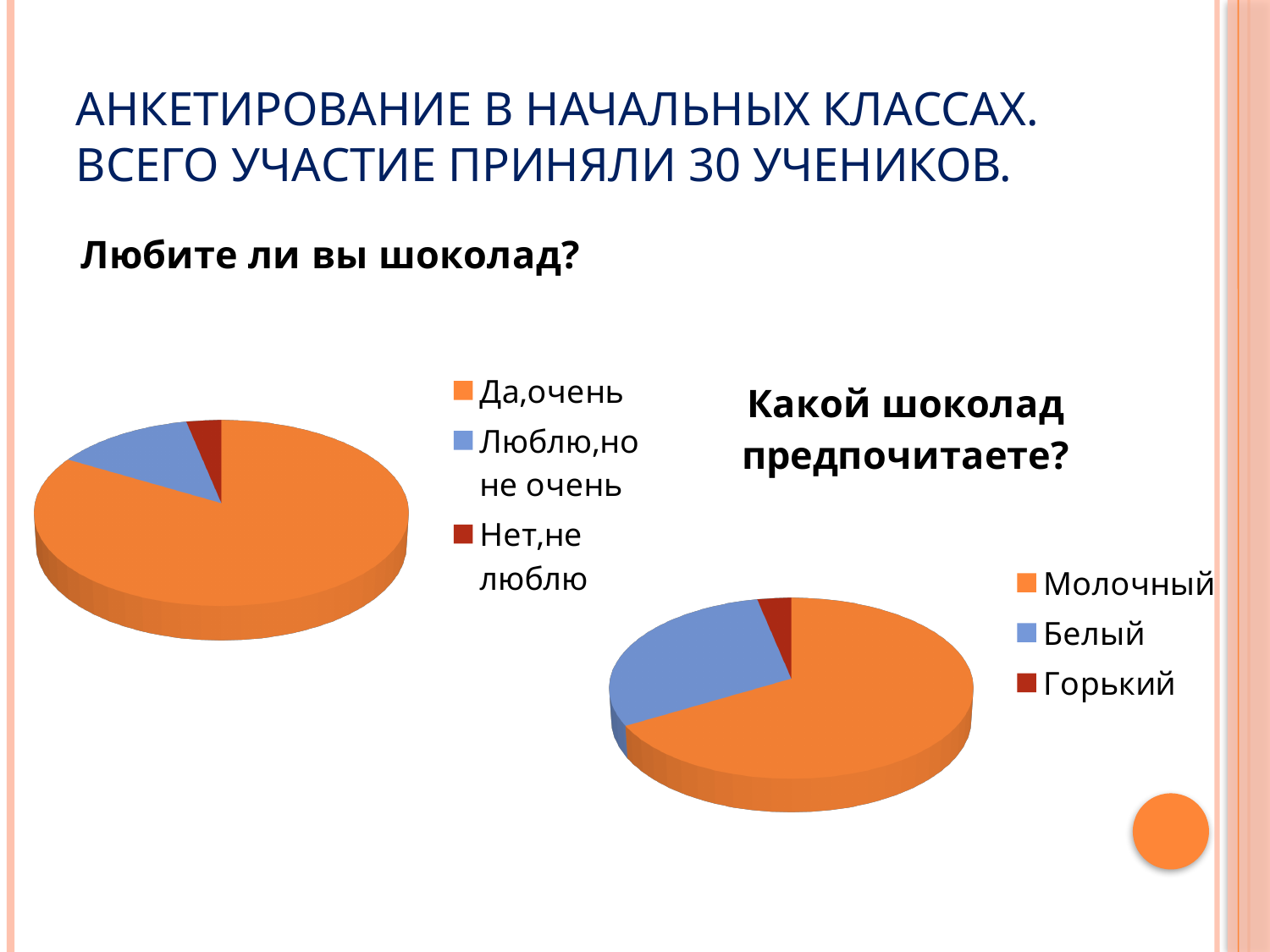
In the chart titled "Какой шоколад предпочитаете?", which slice is larger: Белый or Горький? Белый What kind of chart is the chart titled "Любите ли вы шоколад?"? pie chart How many categories does the chart titled "Любите ли вы шоколад?" show? 3 What kind of chart is the chart titled "Какой шоколад предпочитаете?"? pie chart In the chart titled "Любите ли вы шоколад?", which category has the largest slice? Да,очень How many pie charts are on the slide? 2 In the chart titled "Любите ли вы шоколад?", which slice is larger: Люблю,но не очень or Нет,не люблю? Люблю,но не очень How many categories does the chart titled "Какой шоколад предпочитаете?" show? 3 In the chart titled "Какой шоколад предпочитаете?", which category has the largest slice? Молочный In the chart titled "Какой шоколад предпочитаете?", what colour is the slice for Белый? blue In the chart titled "Какой шоколад предпочитаете?", which category has the smallest slice? Горький In the chart titled "Любите ли вы шоколад?", which category has the smallest slice? Нет,не люблю